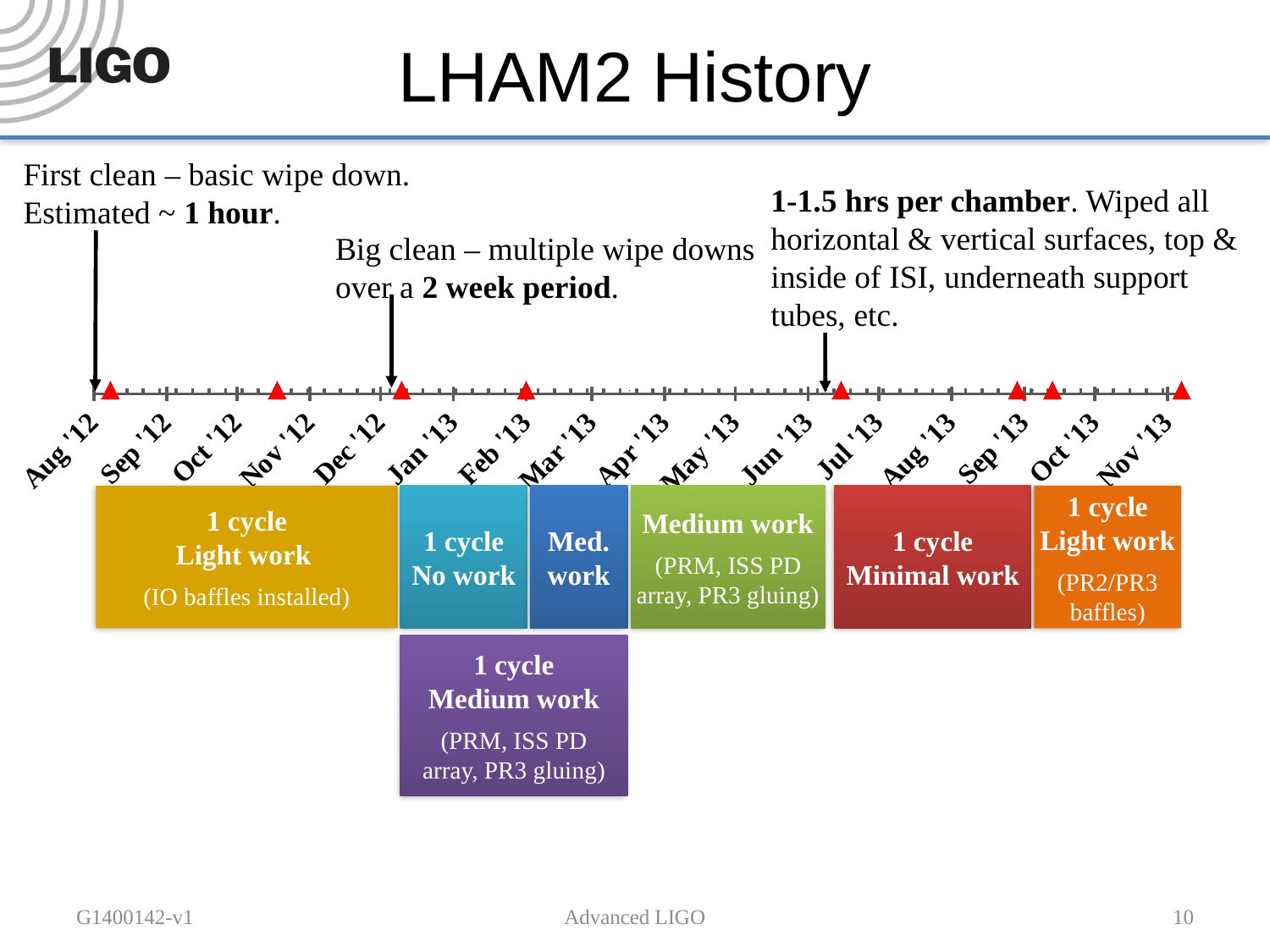
What work level is labelled for the period starting at Jan '13 (the teal box)? 1 cycle No work What is the first month label on the timeline? Aug '12 What colour is the box labelled '1 cycle Light work (IO baffles installed)'? yellow What work level is labelled for the period starting at Jul '13 (the red box)? 1 cycle Minimal work How many red triangle markers are placed on the timeline? 8 How many month labels are shown along the timeline axis? 16 What is the title of the slide containing the timeline? LHAM2 History What kind of chart is shown on the slide? timeline What is the last month label on the timeline? Nov '13